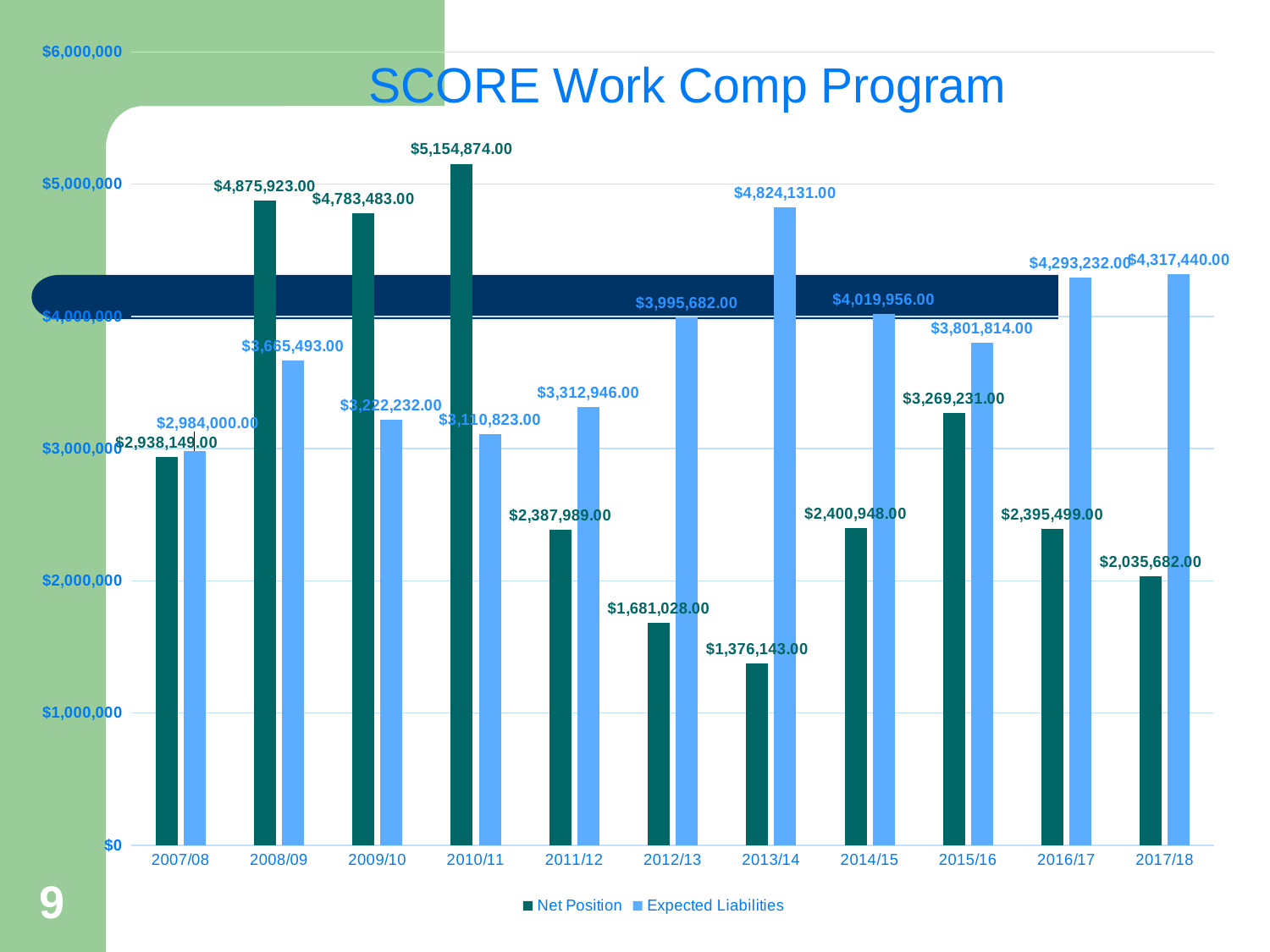
Which year has the lowest Net Position? 2013/14 In 2012/13, which is larger: Net Position or Expected Liabilities? Expected Liabilities Is the Net Position for 2011/12 greater or less than $3,000,000? less What is the difference between Expected Liabilities and Net Position in 2013/14? $3,447,988.00 Which year has the highest Expected Liabilities? 2013/14 Which year has the highest Net Position? 2010/11 How many fiscal years are shown on the x axis? 11 What is the Net Position for 2010/11? $5,154,874.00 What is the Net Position for 2017/18? $2,035,682.00 How many series does the legend list? 2 Does the Net Position rise or fall from 2010/11 to 2013/14? fall What is the Expected Liabilities value for 2013/14? $4,824,131.00